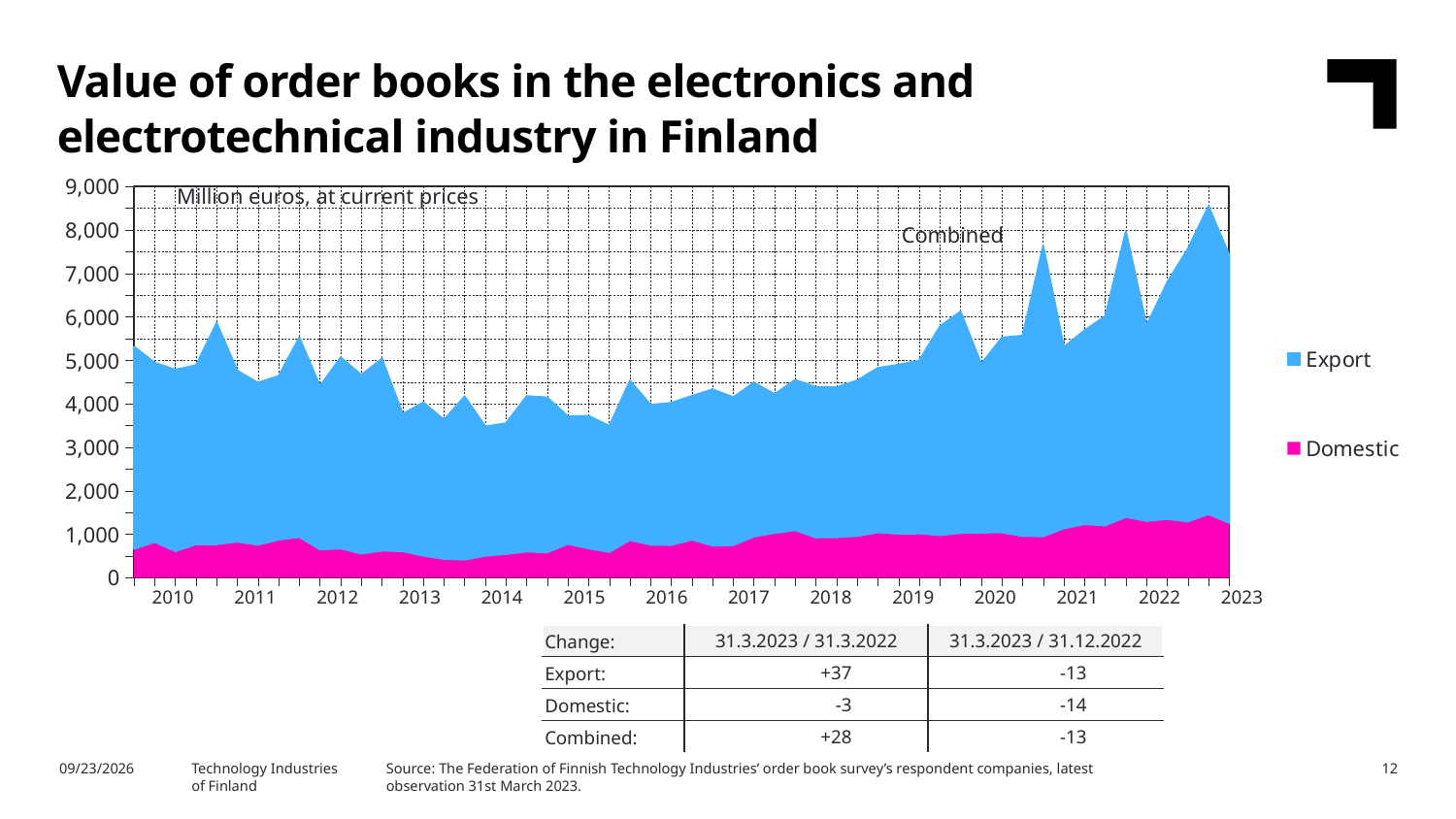
Is the Domestic value in 2014 greater or less than 1,000? less What are the two series named in the chart's legend? Export and Domestic Does the combined value rise or fall from 2010 to 2014? fall Is the Domestic value in 2022 greater or less than 1,000? greater What kind of chart is shown on the slide? Area chart Is the combined value at the peak in late 2022 greater or less than 8,000? greater Which series is larger throughout the chart, Export or Domestic? Export What unit is stated on the chart for the values? Million euros, at current prices How many series does the chart's legend list? 2 Does the combined value generally rise or fall from 2019 to 2023? rise